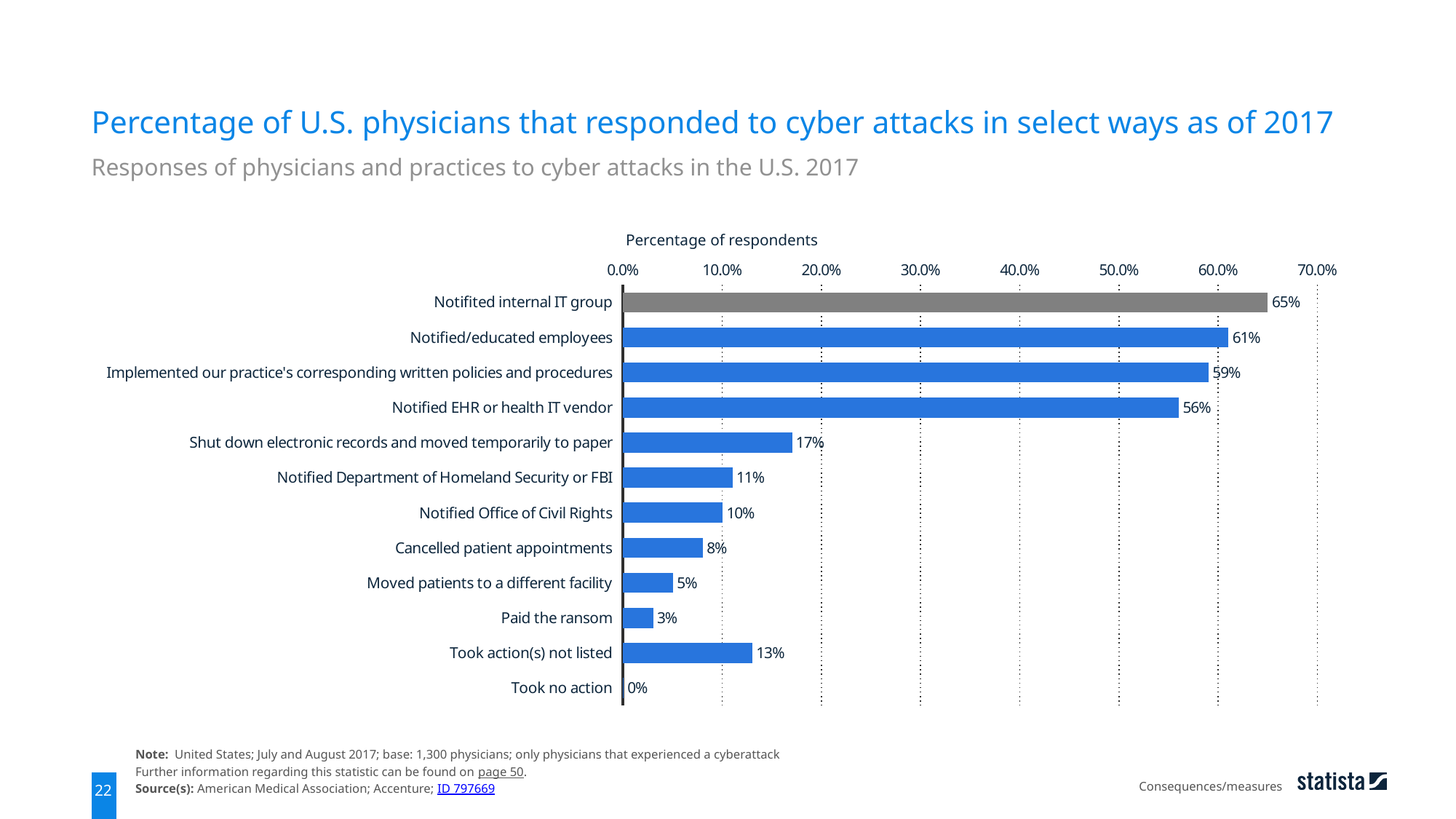
Which response has the highest percentage of respondents? Notifited internal IT group Which is larger: the value for 'Notified Department of Homeland Security or FBI' or the value for 'Took action(s) not listed'? Took action(s) not listed Which response has the lowest percentage of respondents? Took no action How many response categories are shown in the chart? 12 Which bar is coloured grey rather than blue? Notifited internal IT group What percentage of physicians shut down electronic records and moved temporarily to paper? 17% Is the value for 'Implemented our practice's corresponding written policies and procedures' greater or less than 50.0%? greater What is the label of the horizontal axis? Percentage of respondents What kind of chart is shown on the slide? Bar chart What percentage of physicians paid the ransom? 3% What percentage of physicians notified their internal IT group? 65% What is the difference in percentage points between 'Notified/educated employees' and 'Notified EHR or health IT vendor'? 5